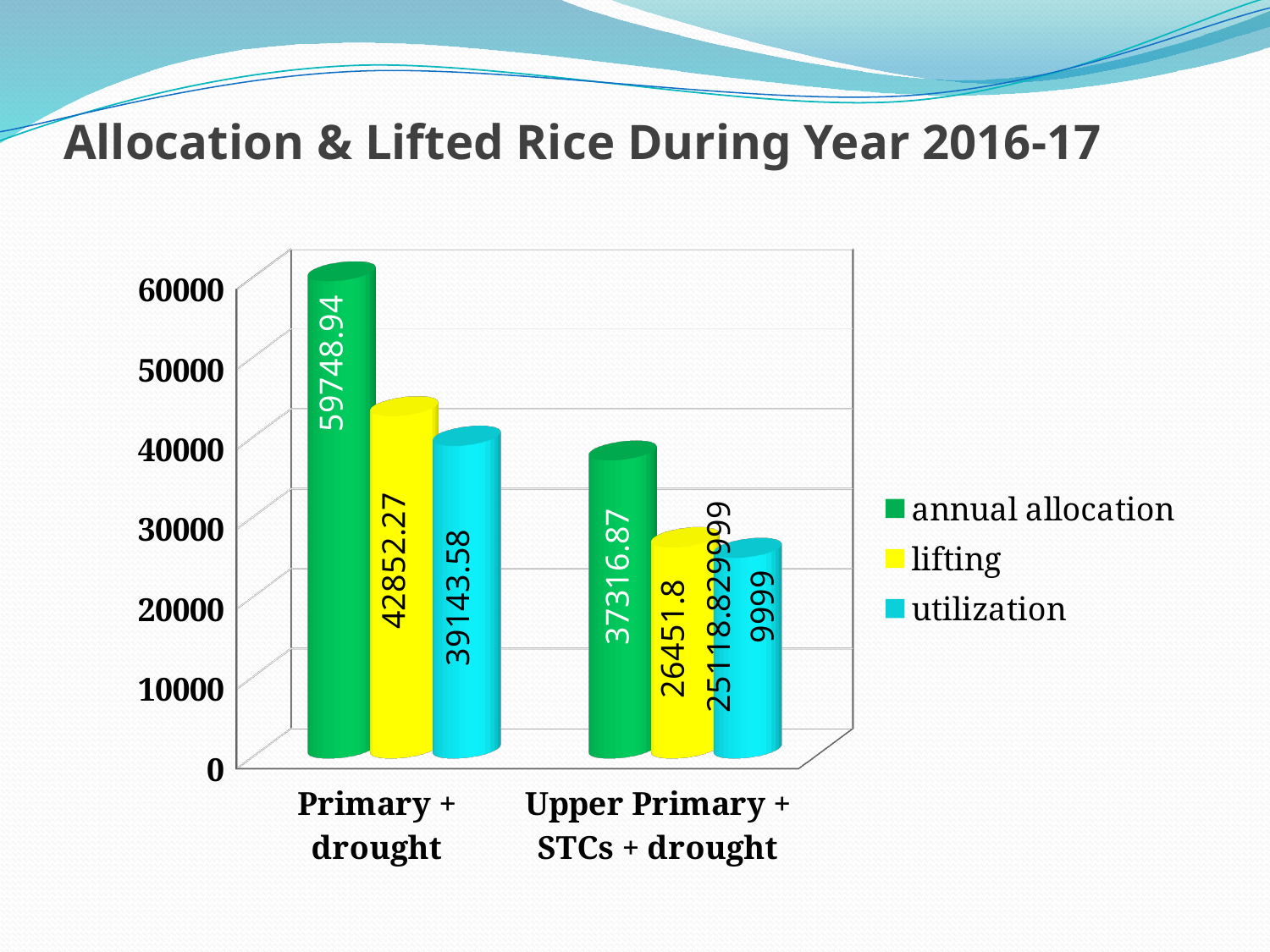
What is the difference between annual allocation and lifting for Primary + drought? 16896.67 How many series does the legend list? 3 What is the lifting value for Primary + drought? 42852.27 Is the utilization value for Upper Primary + STCs + drought greater or less than 30000? less Which category has the highest annual allocation? Primary + drought What is the difference between the annual allocation for Primary + drought and for Upper Primary + STCs + drought? 22432.07 What is the annual allocation value for Primary + drought? 59748.94 What is the lifting value for Upper Primary + STCs + drought? 26451.8 What is the utilization value for Primary + drought? 39143.58 Which series has the lowest value for Upper Primary + STCs + drought? utilization What type of chart is shown on the slide? bar chart What is the annual allocation value for Upper Primary + STCs + drought? 37316.87